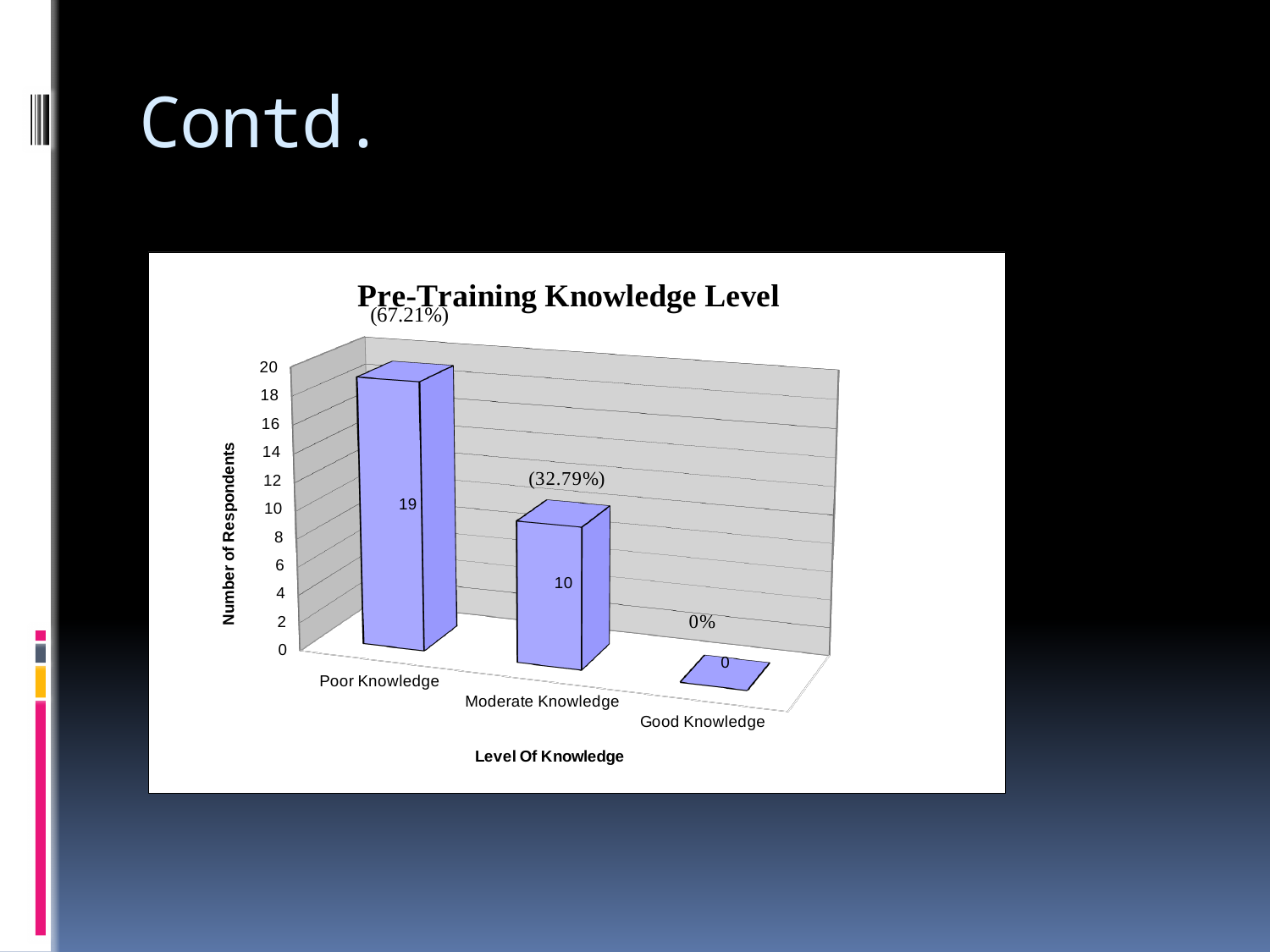
Which has more respondents, Moderate Knowledge or Good Knowledge? Moderate Knowledge What is the number of respondents with Moderate Knowledge? 10 How many levels of knowledge are shown on the x axis? 3 What is the title of the chart? Pre-Training Knowledge Level Which level of knowledge has the lowest number of respondents? Good Knowledge What percentage is shown above the Poor Knowledge bar? (67.21%) What is the number of respondents with Poor Knowledge? 19 Do the values rise or fall from Poor Knowledge to Good Knowledge along the x axis? Fall Which level of knowledge has the highest number of respondents? Poor Knowledge What kind of chart is shown on the slide? Bar chart What is the difference in number of respondents between Poor Knowledge and Moderate Knowledge? 9 What is the number of respondents with Good Knowledge? 0